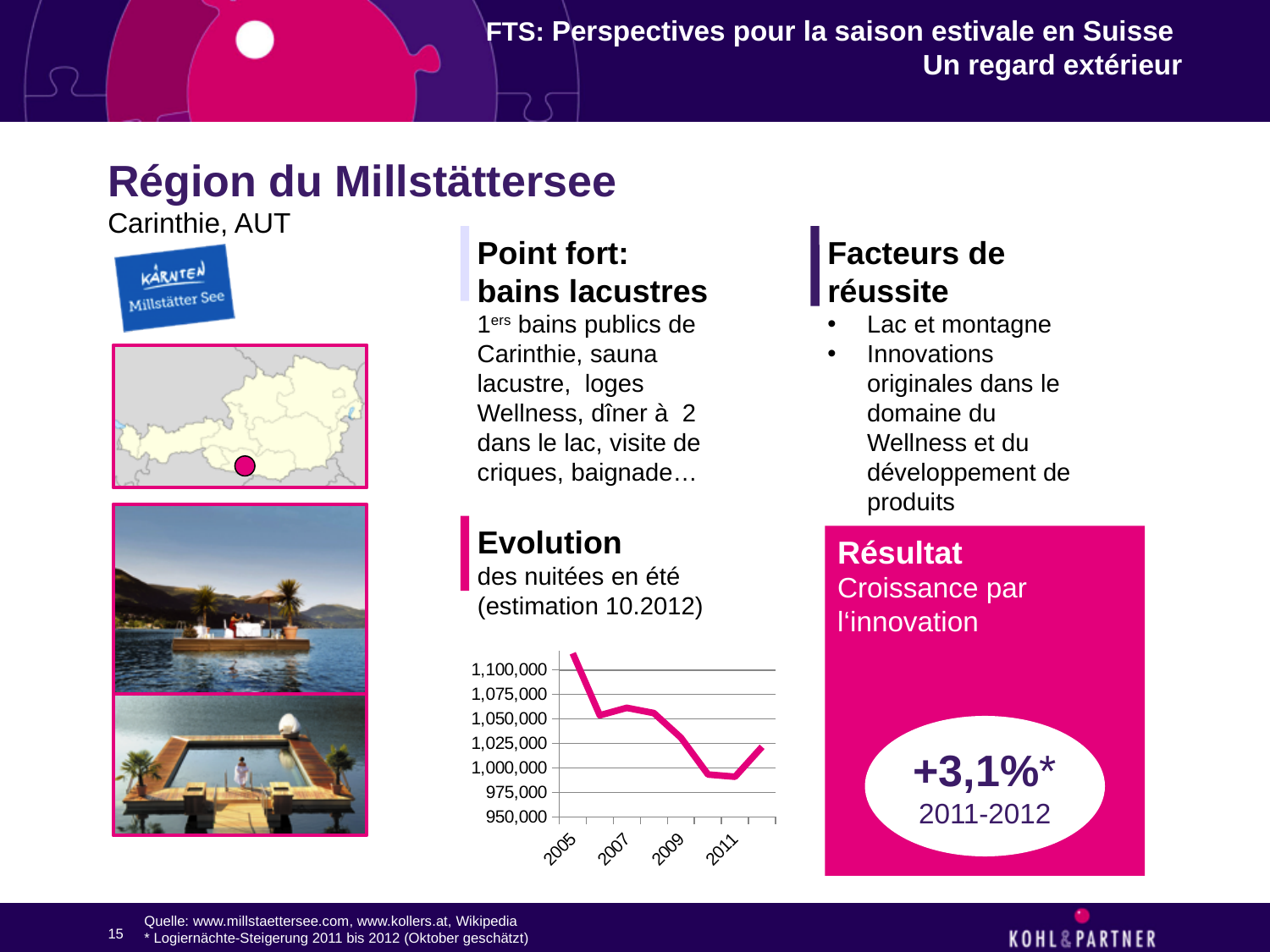
In the line chart, which is larger, the value for 2011 or the value for 2012? 2012 In the line chart, is the value for 2009 greater or less than 1,050,000? less In the line chart, is the value for 2012 greater or less than 1,000,000? greater What is the lowest value printed on the y axis of the line chart? 950,000 In the line chart, is the value for 2011 greater or less than 1,000,000? less In the line chart of summer overnight stays, which year has the highest value? 2005 In the line chart, which is larger, the value for 2005 or the value for 2011? 2005 What kind of chart is shown under the heading 'Evolution des nuitées en été'? line chart In the line chart, do the values generally rise or fall from 2005 to 2011? fall In the line chart, which is larger, the value for 2007 or the value for 2009? 2007 How many year labels are printed on the x axis of the line chart? 4